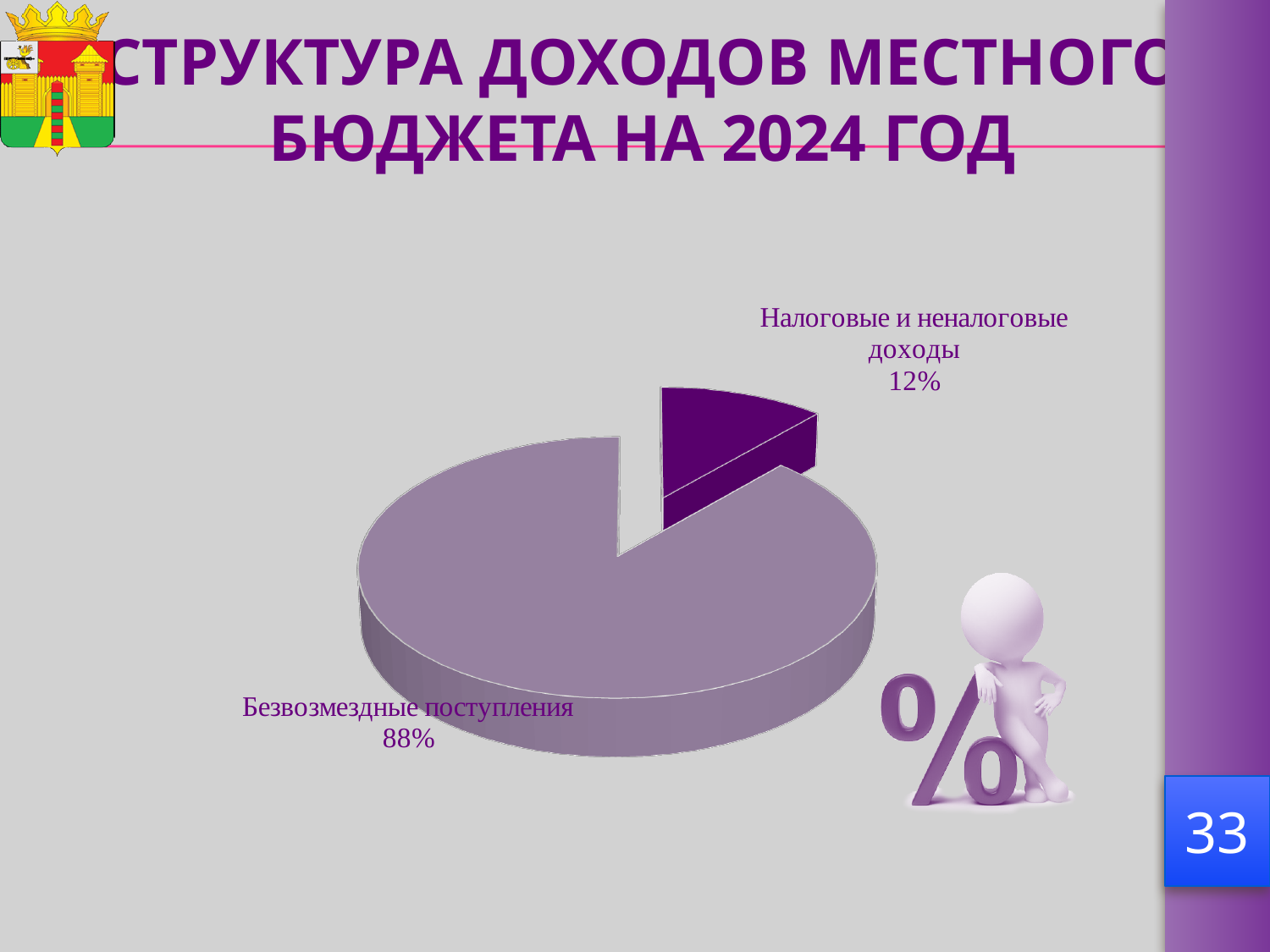
What is the title of the slide containing the chart? СТРУКТУРА ДОХОДОВ МЕСТНОГО БЮДЖЕТА НА 2024 ГОД Which category has the smallest slice of the pie? Налоговые и неналоговые доходы What share of the pie does "Безвозмездные поступления" have? 88% Which category has the largest slice of the pie? Безвозмездные поступления Which slice is pulled out (exploded) from the pie? Налоговые и неналоговые доходы Which is larger: the share of "Безвозмездные поступления" or the share of "Налоговые и неналоговые доходы"? Безвозмездные поступления What share of the pie does "Налоговые и неналоговые доходы" have? 12% What is the difference in percentage points between "Безвозмездные поступления" and "Налоговые и неналоговые доходы"? 76 How many slices does the pie chart have? 2 What kind of chart is shown on the slide? pie chart